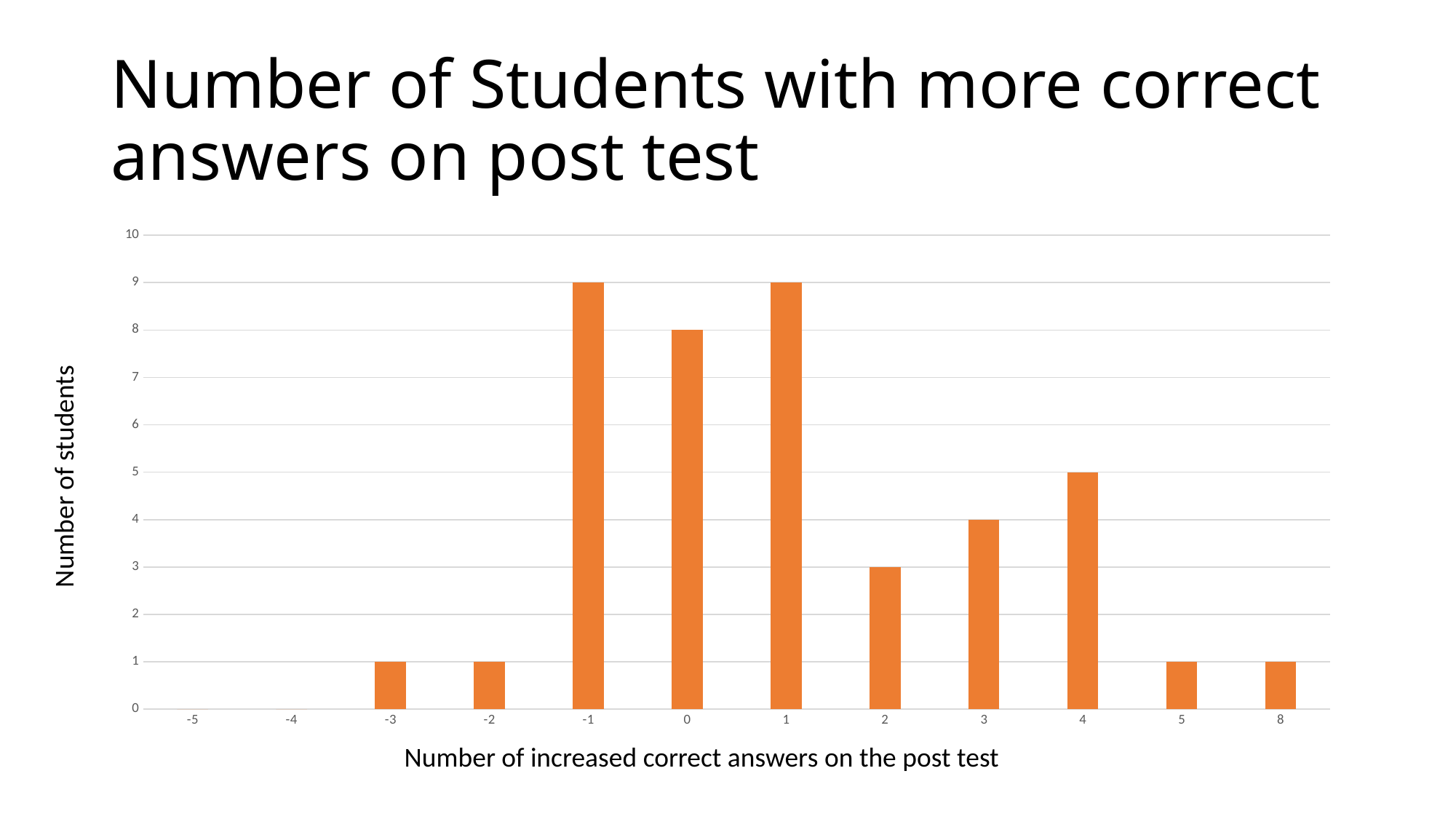
How many categories are shown on the x axis? 12 What is the number of students for the category 2? 3 What is the label of the x axis? Number of increased correct answers on the post test What is the number of students for the category 8? 1 What is the number of students for the category 4? 5 What is the label of the y axis? Number of students Is the value for category 1 greater or less than 6? greater What is the difference between the number of students for category 0 and category 4? 3 What is the number of students for the category -1? 9 What kind of chart is shown on the slide? bar chart Which has more students, category 3 or category 2? 3 How many students had 0 increased correct answers on the post test? 8